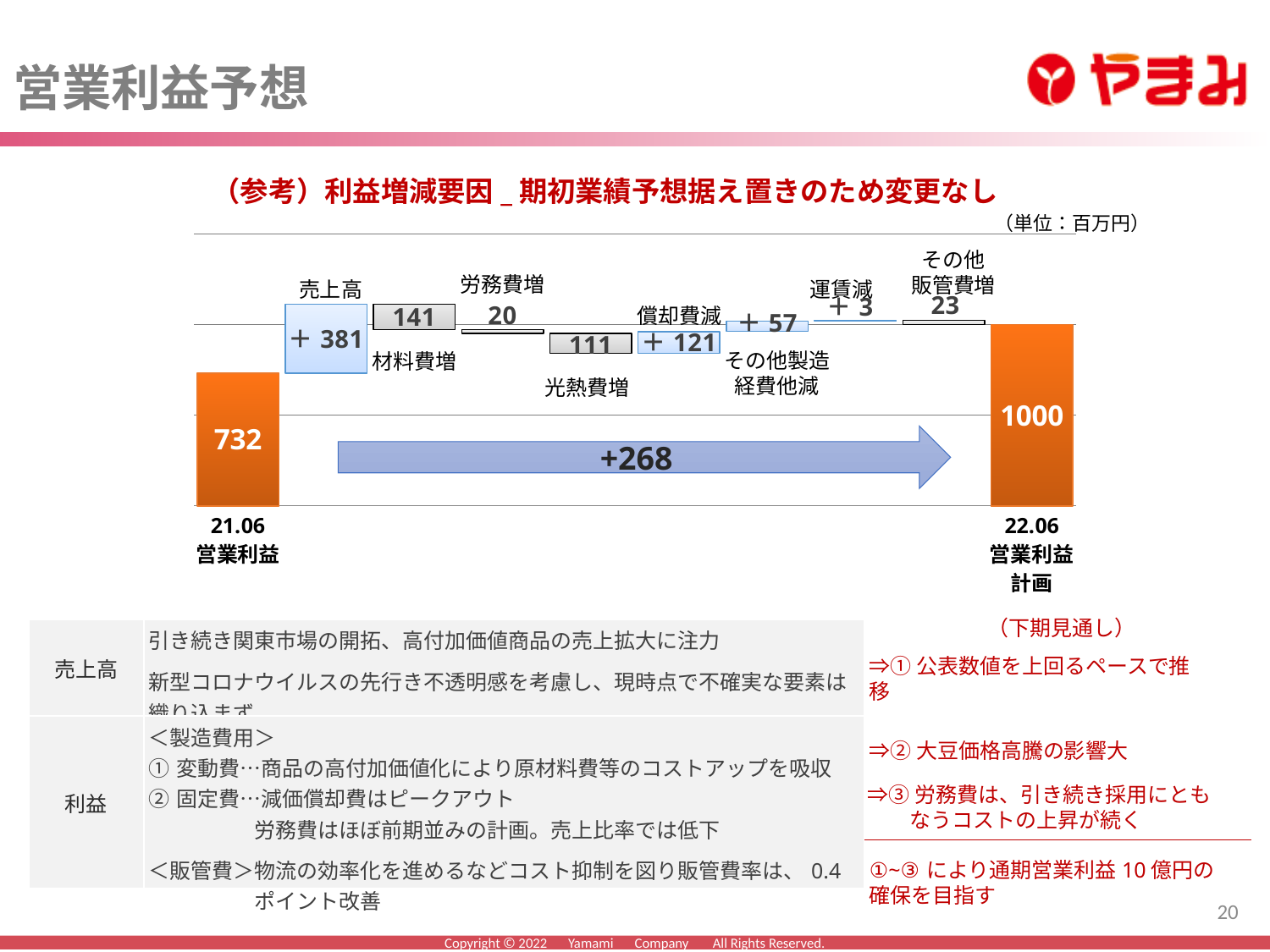
What is the title of the chart? （参考）利益増減要因＿期初業績予想据え置きのため変更なし What is the total change from 21.06 営業利益 to 22.06 営業利益計画 shown on the arrow? +268 What is the value of 22.06 営業利益計画 at the end of the waterfall chart? 1000 Which is larger, the value for 労務費増 or the value for その他販管費増? その他販管費増 What is the value of 21.06 営業利益 at the start of the waterfall chart? 732 What is the contribution of 売上高 shown in the chart? +381 What is the value shown for 運賃減? +3 What unit is stated for the values in the chart? 百万円 What is the value shown for 償却費減? +121 What is the value shown for 材料費増? 141 Which factor has the largest positive contribution in the chart? 売上高 What is the value shown for 光熱費増? 111